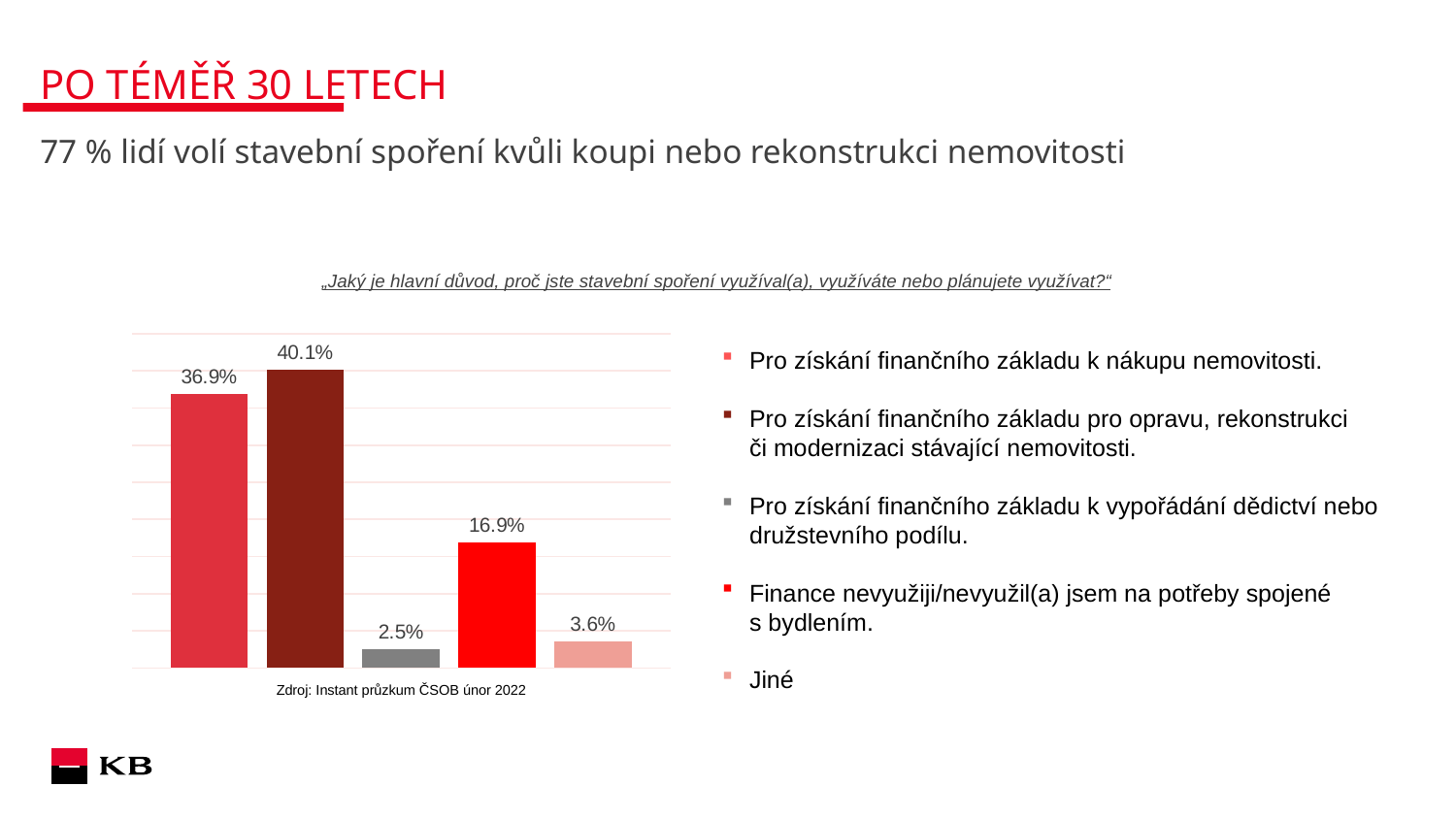
What is the value shown on the first (leftmost) bar of the chart? 36.9% Which bar has the lowest value in the chart? the third bar (2.5%) Which bar has the highest value in the chart? the second bar (40.1%) What is the difference between the second bar (40.1%) and the first bar (36.9%)? 3.2% Which is larger, the fourth bar or the fifth bar? the fourth bar (16.9%) What is the value shown on the fourth bar of the chart? 16.9% What is the value shown on the second bar of the chart? 40.1% What is the value shown on the last (rightmost) bar of the chart? 3.6% How many bars does the chart contain? 5 What is the value shown on the third bar of the chart? 2.5% What source is cited below the chart? Instant průzkum ČSOB únor 2022 What kind of chart is shown on the slide? bar chart